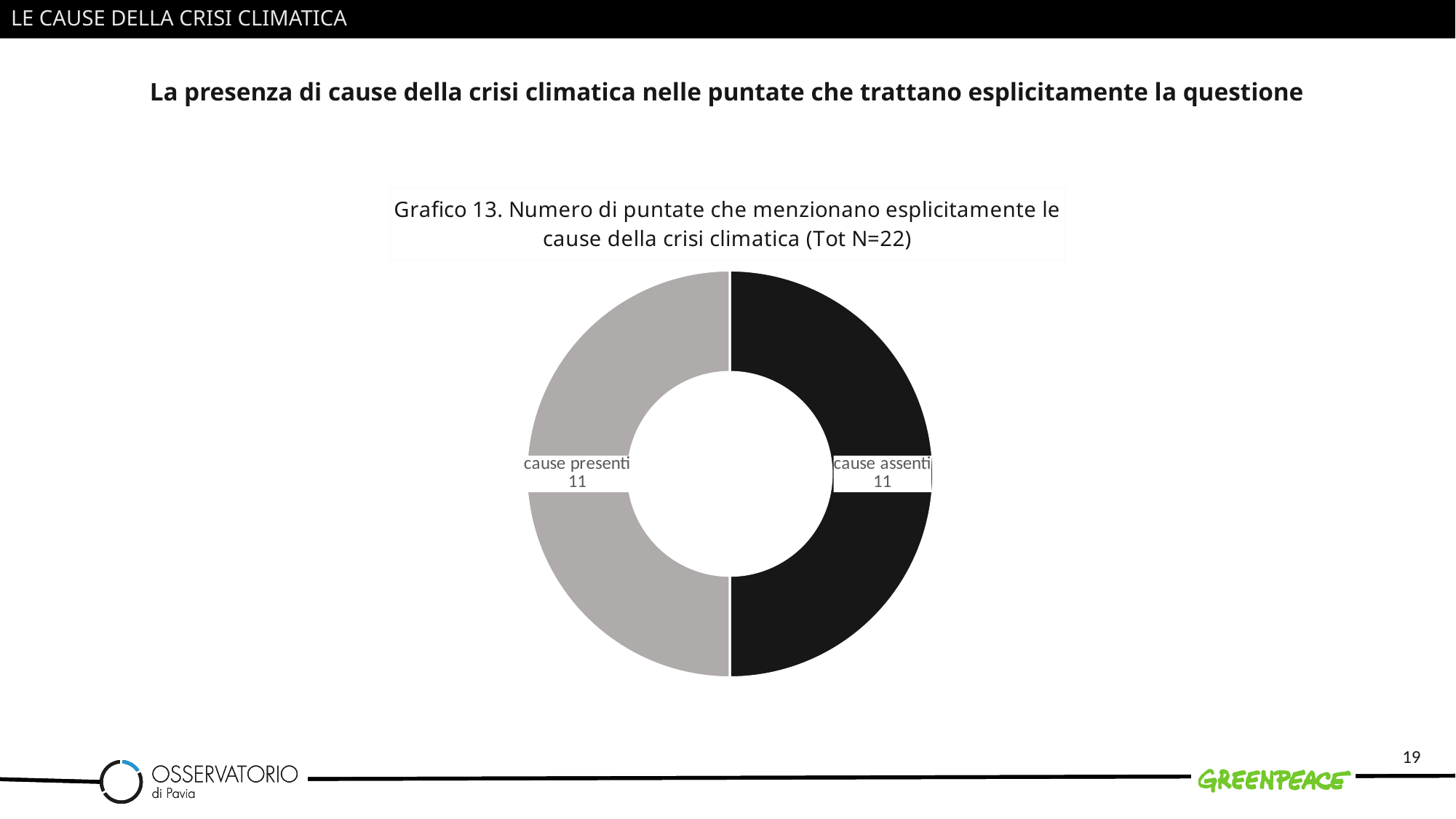
What share of the total does the "cause presenti" slice represent? 50% How many categories (slices) does the chart show? 2 What is the total N stated in the chart title? 22 What share of the total does the "cause assenti" slice represent? 50% Which colour is used for the "cause assenti" slice? Black What is the total of the two slices in the chart? 22 What is the value for "cause presenti" in the chart? 11 What is the value for "cause assenti" in the chart? 11 What is the difference between the values for "cause presenti" and "cause assenti"? 0 Is the value for "cause assenti" greater or less than 10? greater What kind of chart is shown on the slide? Doughnut (pie) chart